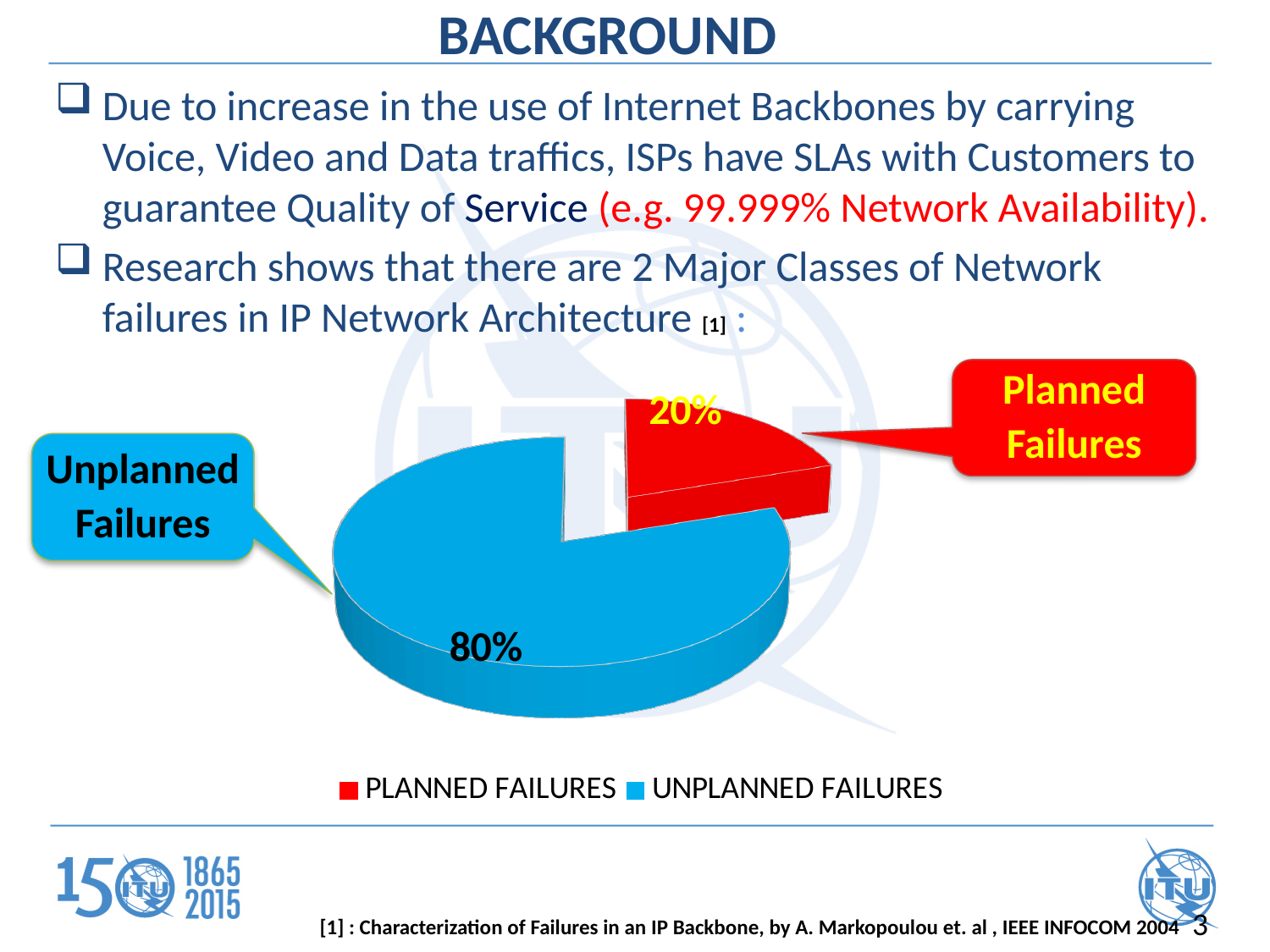
How many slices does the pie chart have? 2 What kind of chart is shown on the slide? pie chart Which is larger, the share for Planned Failures or the share for Unplanned Failures? Unplanned Failures What share of the pie is Unplanned Failures? 80% Which category has the largest share of the pie? Unplanned Failures How many entries does the legend list? 2 What colour is the Unplanned Failures slice? blue What colour is the Planned Failures slice? red What share of the pie is Planned Failures? 20% What is the difference in percentage points between Unplanned Failures and Planned Failures? 60 Which category has the smallest share of the pie? Planned Failures